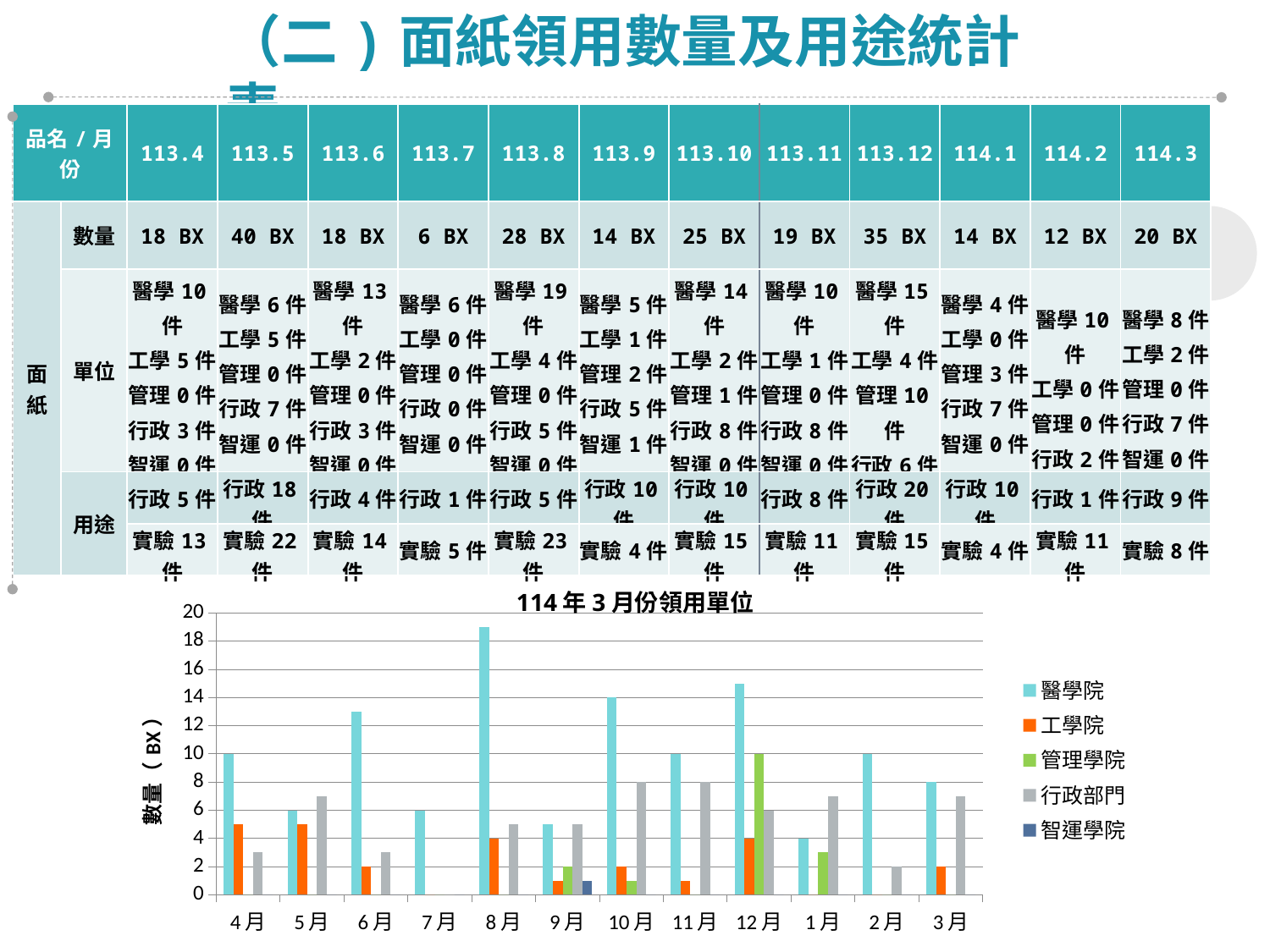
What is the title of the chart? 114年3月份領用單位 What is the value for 行政部門 in 10月? 8 How many months are shown along the x axis of the chart? 12 What is the value for 醫學院 in 4月? 10 In which month is the 醫學院 bar the lowest? 1月 What kind of chart is shown below the table? bar chart Is the value for 行政部門 in 5月 greater or less than 6? greater In which month is the 醫學院 bar the highest? 8月 What is the value for 管理學院 in 12月? 10 Is the value for 醫學院 in 8月 greater or less than 18? greater In 4月, which is larger: 醫學院 or 工學院? 醫學院 How many series does the chart legend list? 5